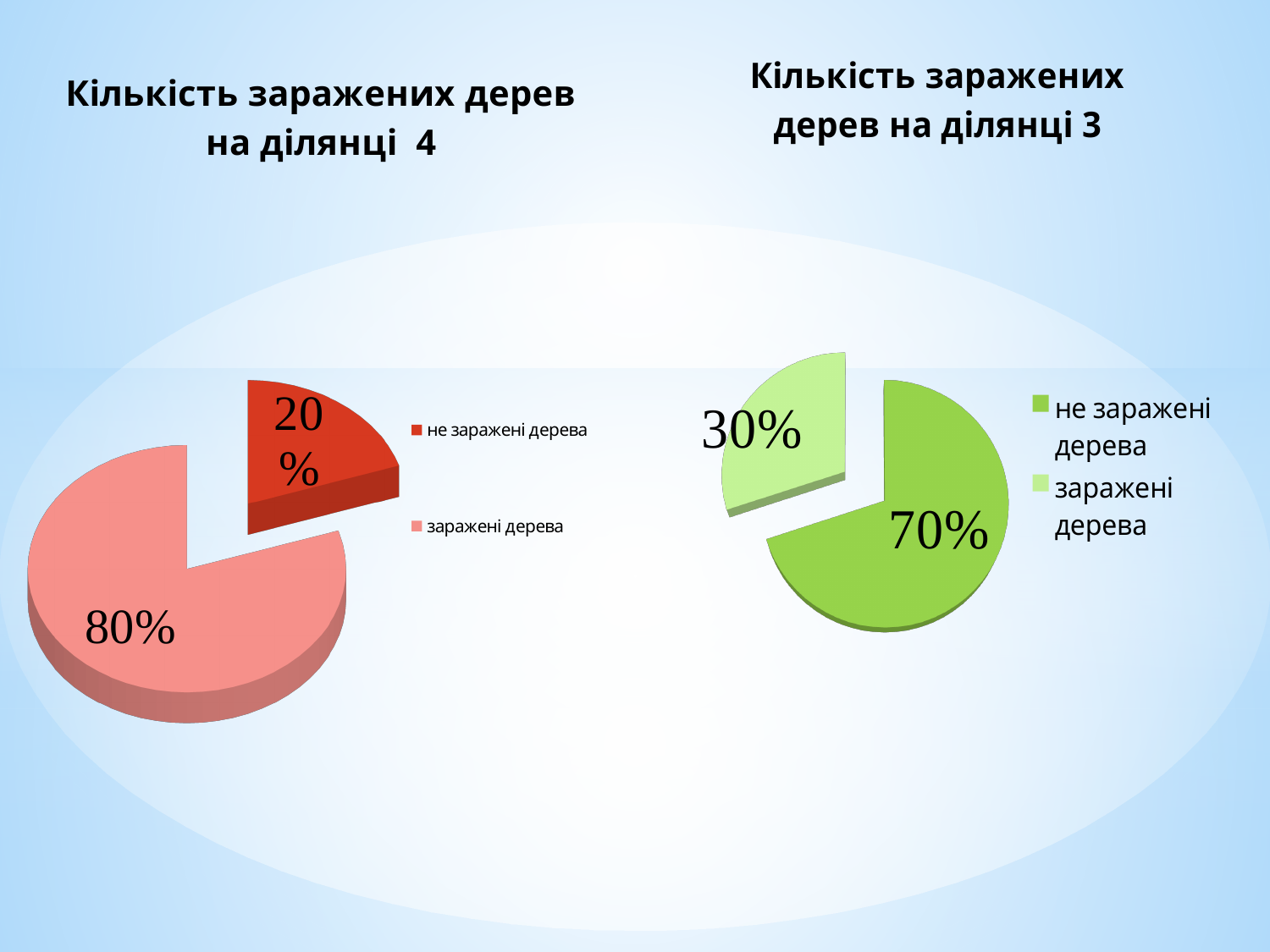
In the chart titled "Кількість заражених дерев на ділянці 3", what colour is the "заражені дерева" slice? light green How many categories does the legend of the chart titled "Кількість заражених дерев на ділянці 4" list? 2 In the chart titled "Кількість заражених дерев на ділянці 4", which category has the largest slice? заражені дерева In the chart titled "Кількість заражених дерев на ділянці 4", what is the difference between the "заражені дерева" and "не заражені дерева" shares? 60% Which is larger: the "заражені дерева" share in the chart for ділянка 4 or the "заражені дерева" share in the chart for ділянка 3? ділянка 4 In the chart titled "Кількість заражених дерев на ділянці 3", what is the difference between the "не заражені дерева" and "заражені дерева" shares? 40% What type of chart is the chart titled "Кількість заражених дерев на ділянці 3"? pie chart In the chart titled "Кількість заражених дерев на ділянці 4", what share of the pie is "не заражені дерева"? 20% In the chart titled "Кількість заражених дерев на ділянці 3", what share of the pie is "не заражені дерева"? 70% In the chart titled "Кількість заражених дерев на ділянці 4", what share of the pie is "заражені дерева"? 80% In the chart titled "Кількість заражених дерев на ділянці 3", which category has the smallest slice? заражені дерева In the chart titled "Кількість заражених дерев на ділянці 3", what share of the pie is "заражені дерева"? 30%